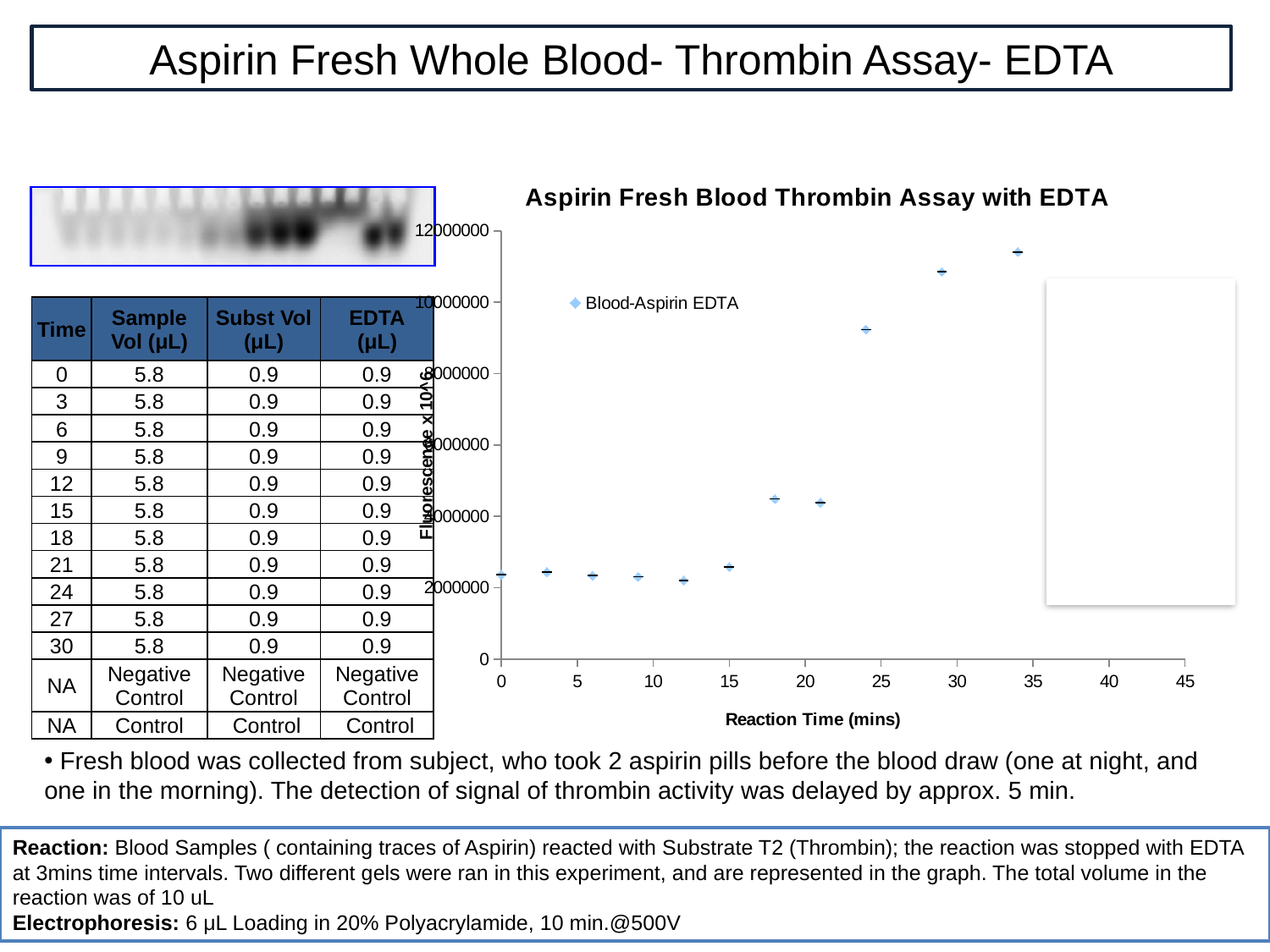
Which has the larger fluorescence value, reaction time 9 or reaction time 18? reaction time 18 What kind of chart is shown on the slide? scatter chart What is the label of the x axis of the chart? Reaction Time (mins) Is the fluorescence value at reaction time 18 greater or less than 4000000? greater What is the title of the chart? Aspirin Fresh Blood Thrombin Assay with EDTA Is the fluorescence value at reaction time 24 greater or less than 10000000? less How many data points are plotted in the chart? 11 What is the name of the series shown in the chart legend? Blood-Aspirin EDTA Is the fluorescence value at reaction time 0 greater or less than 4000000? less How many series does the chart legend list? 1 Do the fluorescence values generally rise or fall as reaction time increases? rise